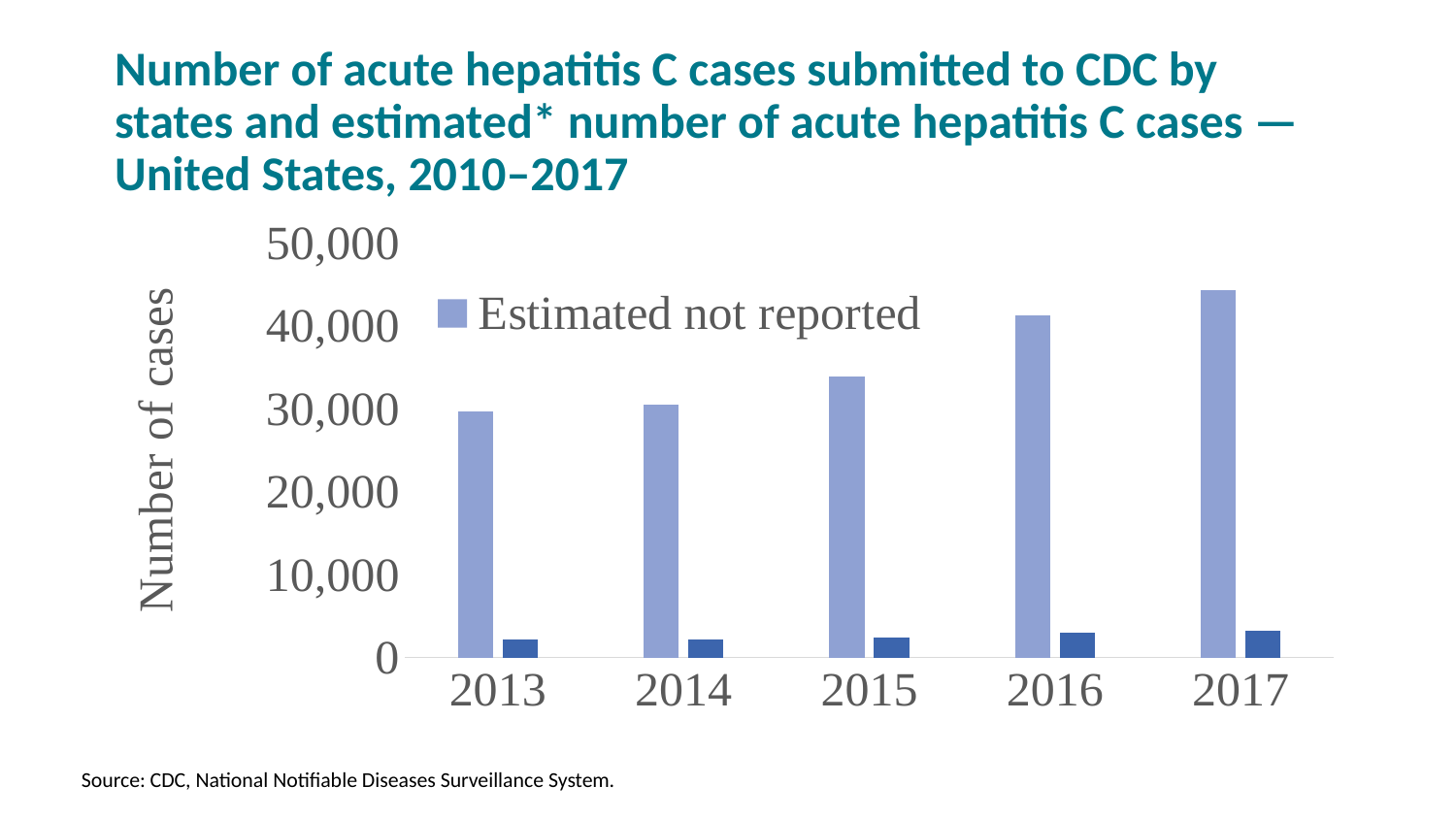
What is the label on the vertical axis of the chart? Number of cases Is the Estimated not reported value for 2017 greater or less than 40,000? greater Which year has the highest value for Estimated not reported? 2017 Which year has the lowest value for Estimated not reported? 2013 What series name is shown in the chart legend? Estimated not reported Do the Estimated not reported values rise or fall from 2013 to 2017? rise How many years are shown on the x axis of the chart? 5 What kind of chart is shown on the slide? bar chart Is the dark blue bar for 2017 greater or less than 10,000? less Is the Estimated not reported value for 2015 greater or less than 40,000? less Which is larger, the Estimated not reported value for 2016 or for 2014? 2016